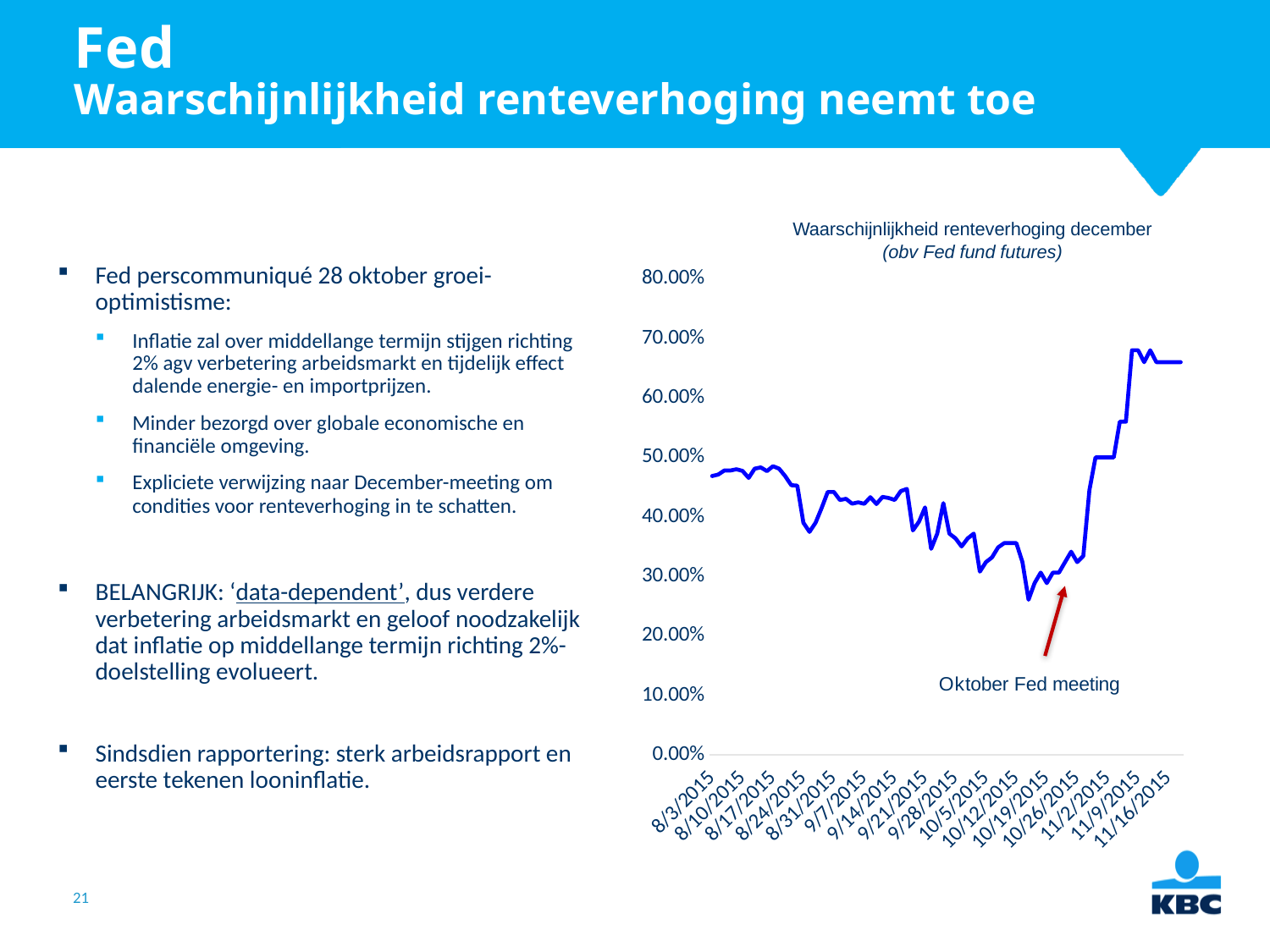
Is the value for 9/14/2015 greater or less than 50%? less Is the value for 11/16/2015 greater or less than 60%? greater How many date labels are shown on the x axis? 16 Does the line rise or fall between 8/3/2015 and 10/19/2015? fall What kind of chart is shown on the slide? line chart Is the value for 10/19/2015 greater or less than 40%? less Does the line rise or fall between 10/26/2015 and 11/9/2015? rise In which month does the line reach its lowest point? October What event does the red arrow annotation on the chart point to? Oktober Fed meeting Which is larger, the value at 8/3/2015 or the value at 11/16/2015? 11/16/2015 What is the title of the chart? Waarschijnlijkheid renteverhoging december (obv Fed fund futures)